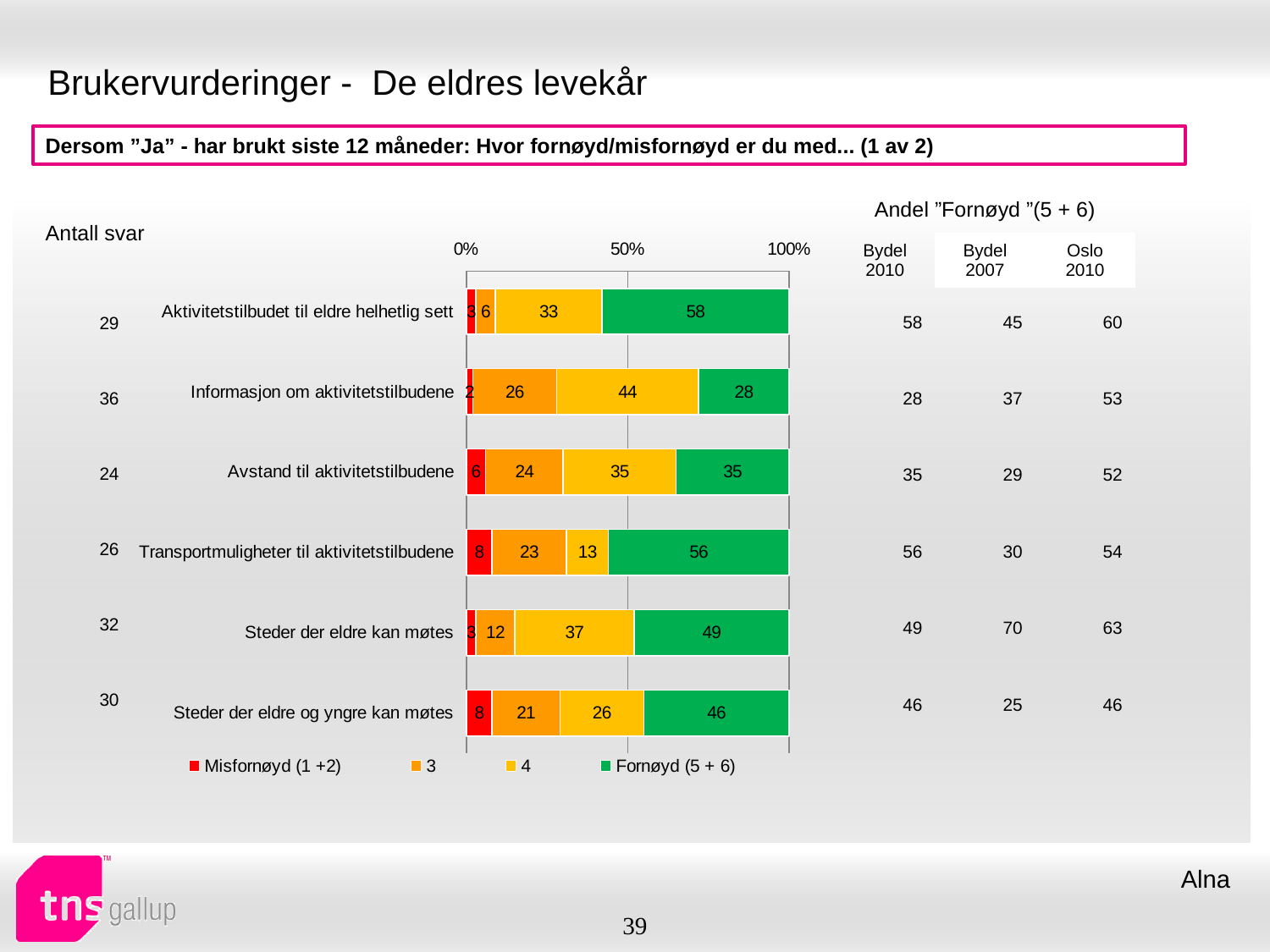
What is the value of the "4" segment for "Informasjon om aktivitetstilbudene"? 44 How many categories are shown in the chart? 6 What kind of chart is shown on the slide? Stacked bar chart What is the total of the stacked bar for "Transportmuligheter til aktivitetstilbudene"? 100 What is the value of the "Fornøyd (5 + 6)" segment for "Aktivitetstilbudet til eldre helhetlig sett"? 58 Which is larger: the "3" segment for "Avstand til aktivitetstilbudene" or the "3" segment for "Steder der eldre kan møtes"? Avstand til aktivitetstilbudene Which category has the highest "Fornøyd (5 + 6)" value? Aktivitetstilbudet til eldre helhetlig sett What is the value of the "Misfornøyd (1 +2)" segment for "Transportmuligheter til aktivitetstilbudene"? 8 What is the difference between the "Fornøyd (5 + 6)" values for "Steder der eldre kan møtes" and "Steder der eldre og yngre kan møtes"? 3 How many series does the legend list? 4 What colour represents the "Fornøyd (5 + 6)" series in the chart? Green Which category has the lowest "Fornøyd (5 + 6)" value? Informasjon om aktivitetstilbudene